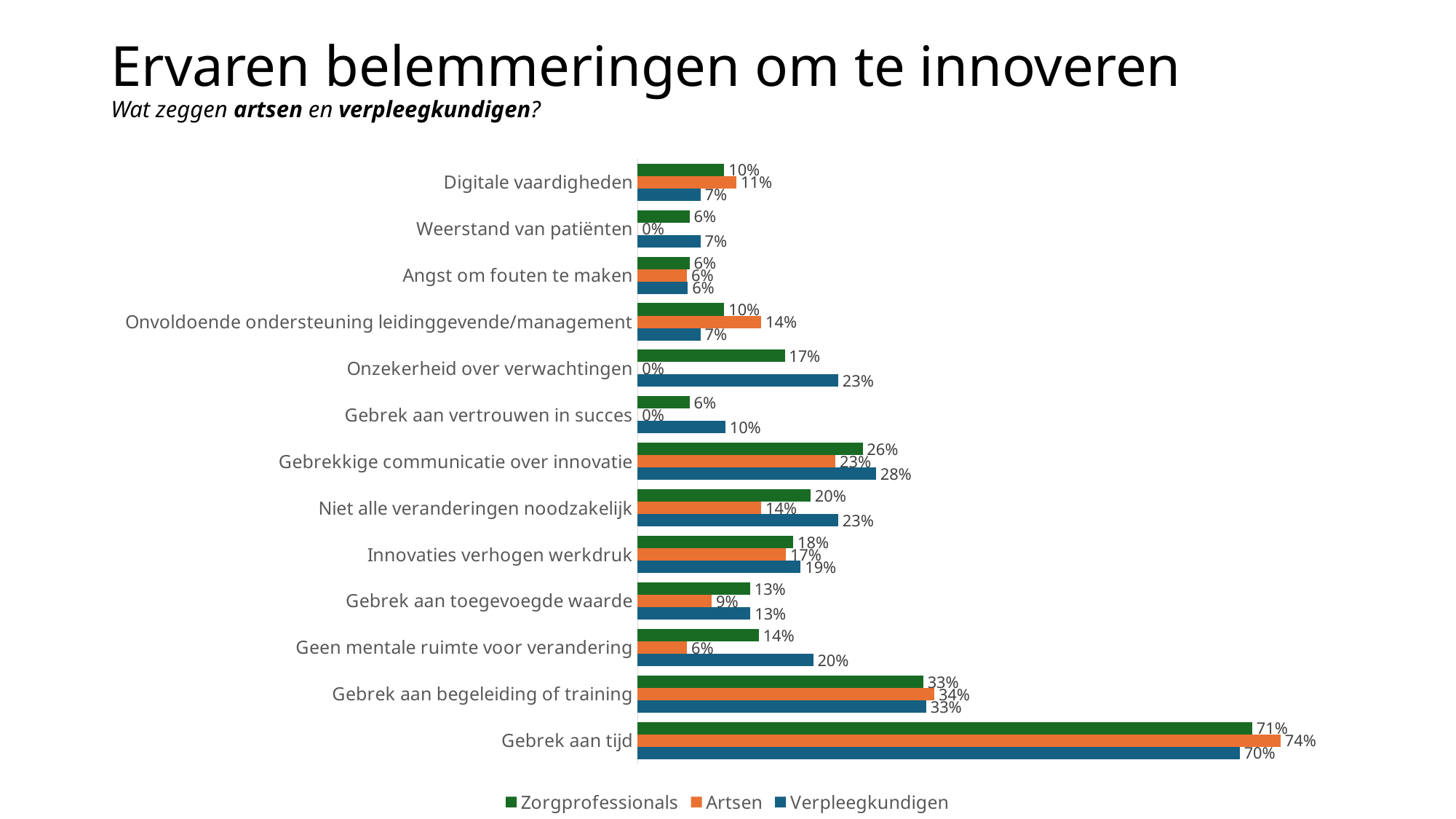
What is the difference between the Zorgprofessionals and Verpleegkundigen values for 'Gebrek aan vertrouwen in succes'? 4% What is the value for Verpleegkundigen for 'Onzekerheid over verwachtingen'? 23% What is the difference between the Artsen and Verpleegkundigen values for 'Geen mentale ruimte voor verandering'? 14% What is the value for Artsen for 'Gebrek aan tijd'? 74% What is the value for Artsen for 'Weerstand van patiënten'? 0% How many categories are shown on the chart? 13 What kind of chart is shown on the slide? Bar chart Which is larger for 'Niet alle veranderingen noodzakelijk': the Zorgprofessionals value or the Artsen value? Zorgprofessionals Which category has the highest value for Verpleegkundigen? Gebrek aan tijd What is the value for Zorgprofessionals for 'Gebrekkige communicatie over innovatie'? 26% How many series does the legend list? 3 Which series is shown in orange in the legend? Artsen